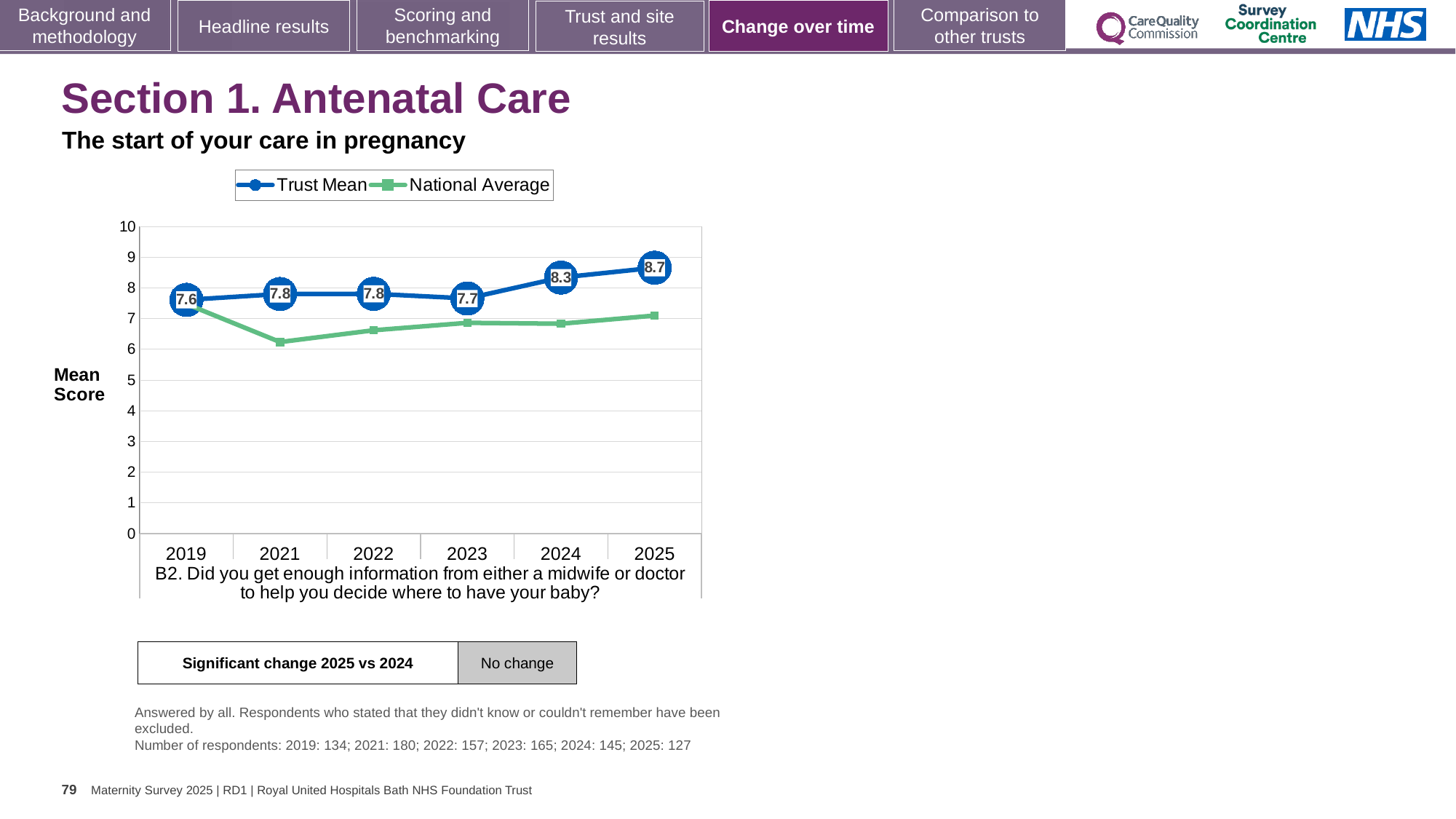
What is the difference between the Trust Mean in 2025 and in 2024? 0.4 What kind of chart is shown on the slide? Line chart Is the National Average value for 2022 greater or less than 7? less How many series does the legend list? 2 How many years are shown on the x axis? 6 In which year is the Trust Mean highest? 2025 In which year is the Trust Mean lowest? 2019 What is the Trust Mean score for 2019? 7.6 What is the Trust Mean score for 2023? 7.7 Is the National Average value for 2021 greater or less than 7? less Which is larger, the Trust Mean in 2024 or the Trust Mean in 2022? 2024 What is the Trust Mean score for 2025? 8.7